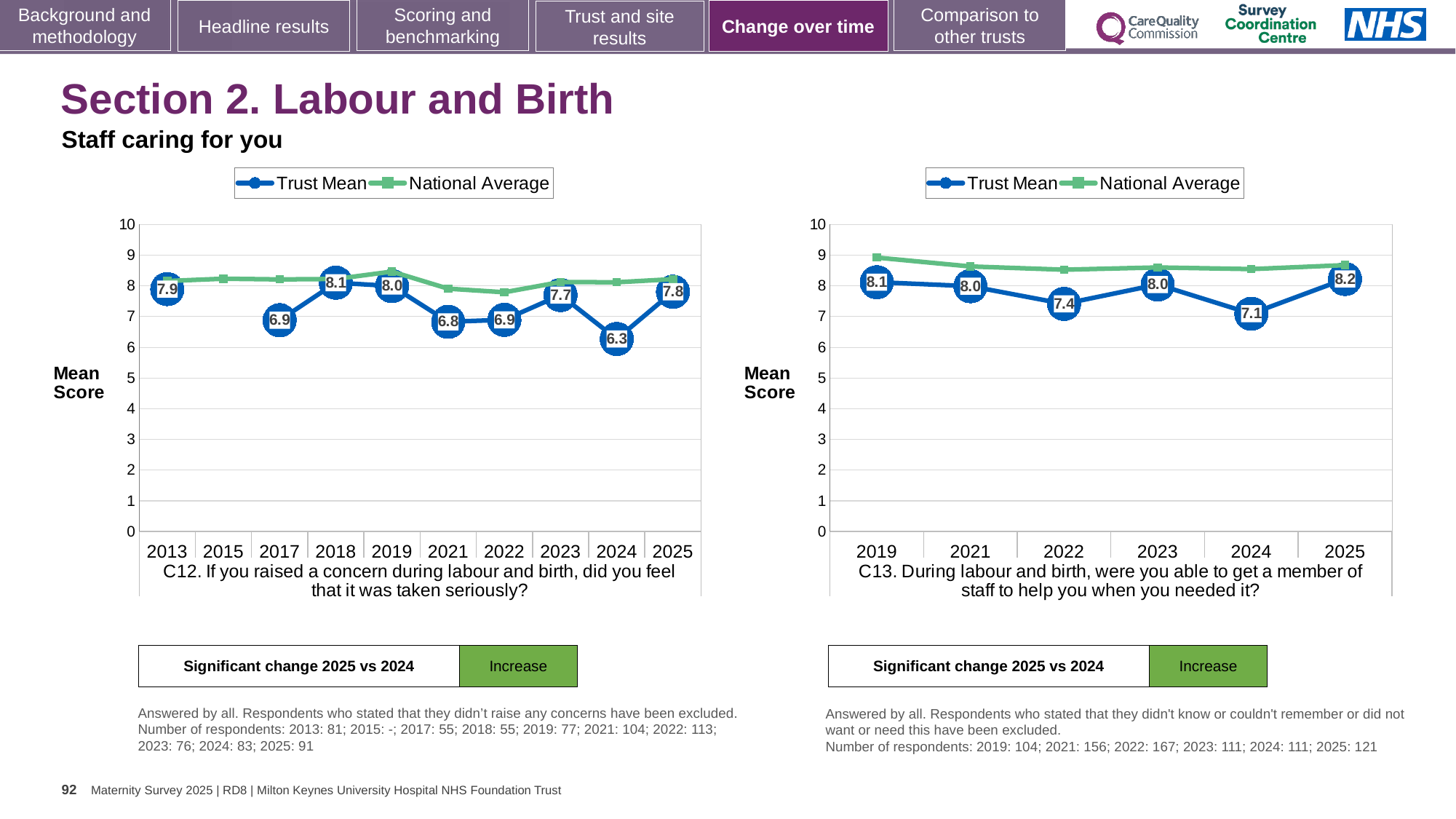
In the C13 chart on the right, which year has the highest Trust Mean? 2025 In the C13 chart on the right, is the National Average for 2019 greater or less than 8? greater What kind of chart is the C12 chart on the left? Line chart In the C12 chart on the left, how many years are shown on the x axis? 10 In the C13 chart on the right, which is larger, the Trust Mean for 2024 or for 2025? 2025 In the C12 chart on the left, what is the Trust Mean for 2024? 6.3 In the C13 chart on the right, what is the Trust Mean for 2022? 7.4 How many series does the legend of the C13 chart on the right list? 2 In the C12 chart on the left, which year has the lowest Trust Mean? 2024 In the C12 chart on the left, is the National Average for 2013 greater or less than 7? greater In the C12 chart on the left, what is the Trust Mean for 2018? 8.1 In the C12 chart on the left, what is the difference between the Trust Mean for 2025 and 2024? 1.5